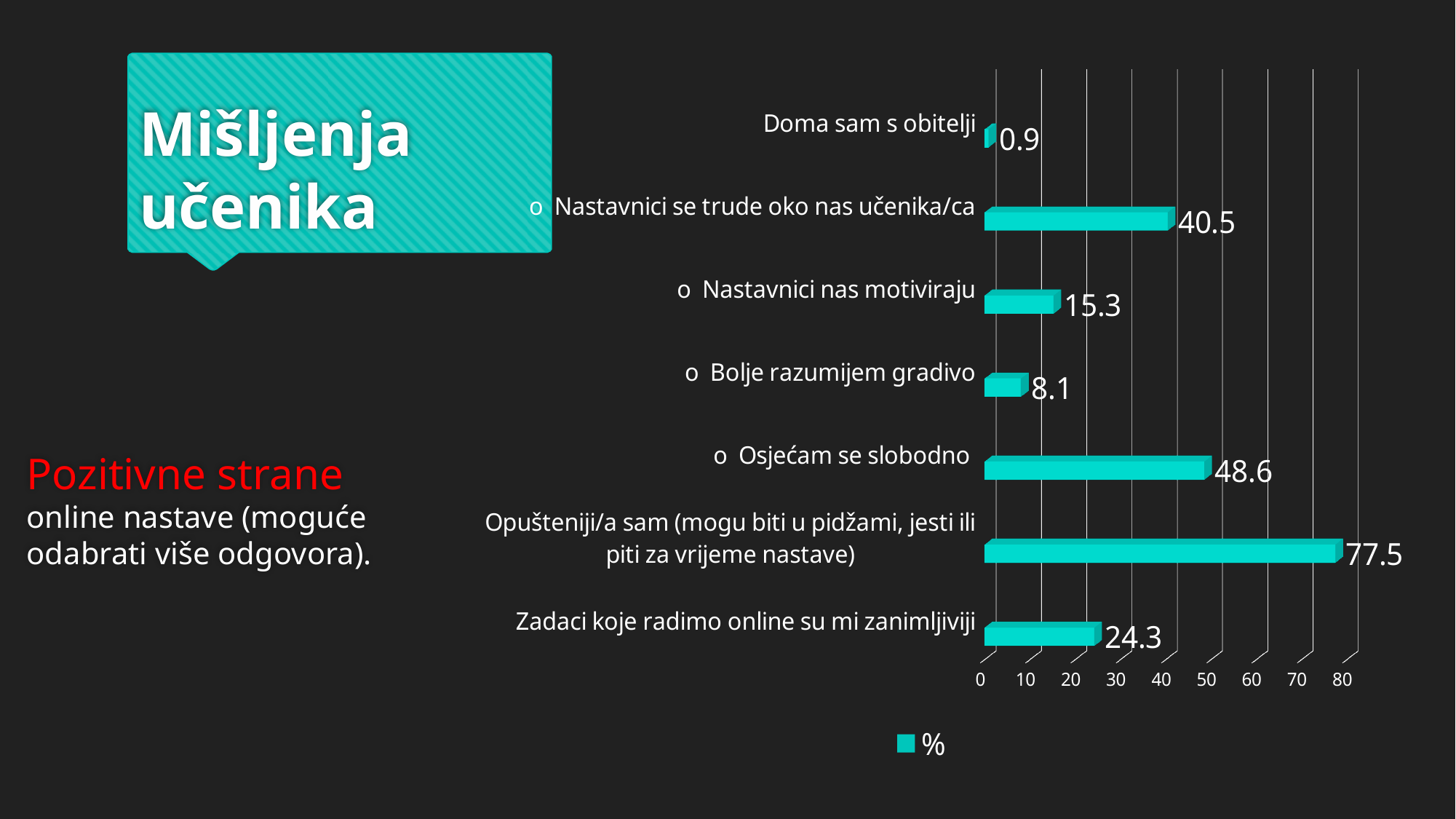
What is the value for "Osjećam se slobodno"? 48.6 What is the value for "Zadaci koje radimo online su mi zanimljiviji"? 24.3 What is the legend entry for the series in the chart? % What is the difference between the values for "Osjećam se slobodno" and "Nastavnici se trude oko nas učenika/ca"? 8.1 What is the value for "Nastavnici nas motiviraju"? 15.3 Which is larger: the value for "Bolje razumijem gradivo" or the value for "Nastavnici nas motiviraju"? Nastavnici nas motiviraju Is the value for "Opušteniji/a sam" greater or less than 70? greater How many series does the legend list? 1 What kind of chart is shown on the slide? bar chart How many categories are shown in the chart? 7 Which category has the lowest value? Doma sam s obitelji Which category has the highest value? Opušteniji/a sam (mogu biti u pidžami, jesti ili piti za vrijeme nastave)